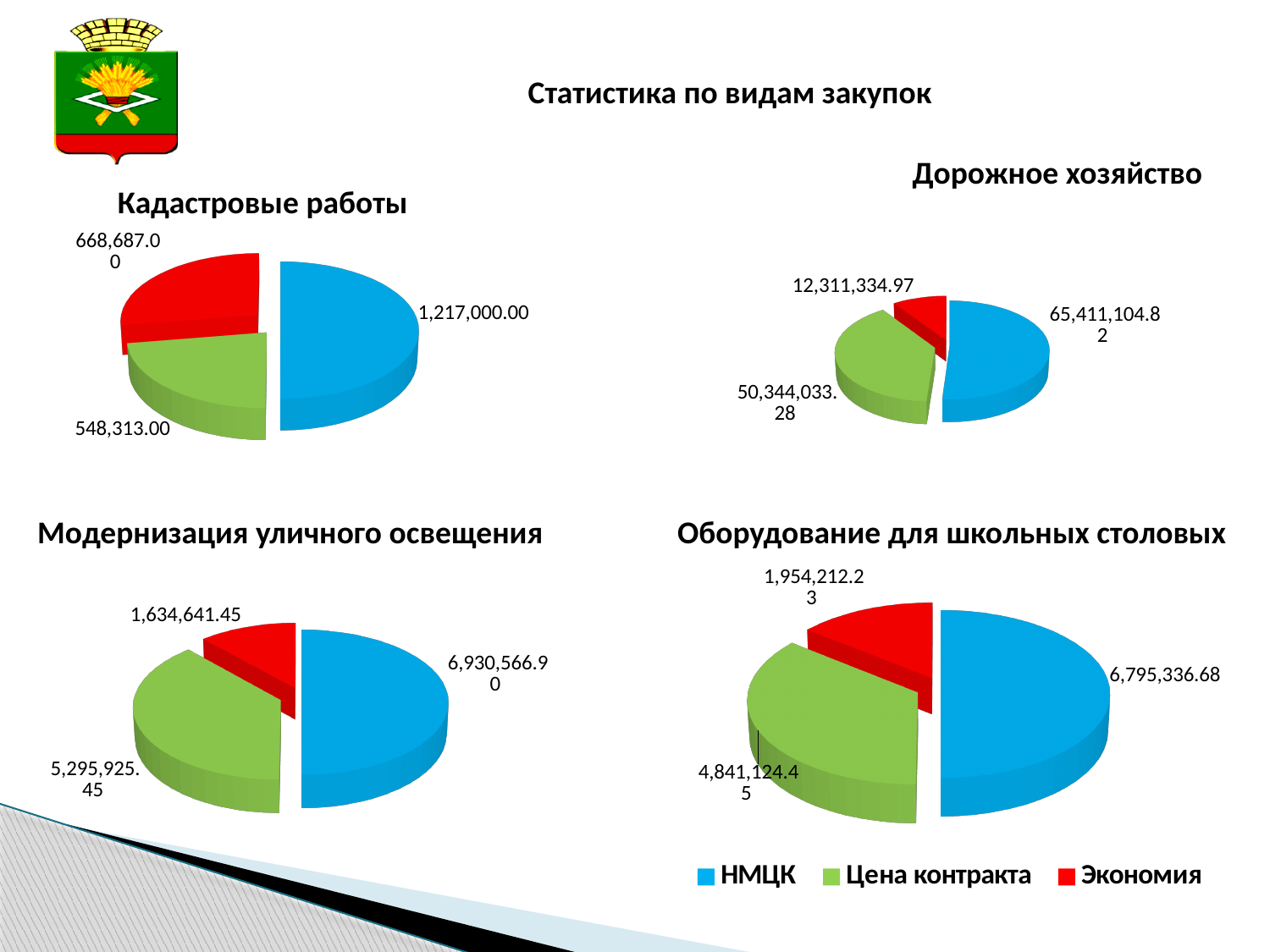
Which colour represents Цена контракта in the legend? Green How many series does the legend list? 3 What kind of charts are shown on the slide? Pie charts In the 'Кадастровые работы' chart, what is the value for Цена контракта? 548,313.00 In the 'Дорожное хозяйство' chart, which slice is the smallest? Экономия In the 'Кадастровые работы' chart, which is larger: Экономия or Цена контракта? Экономия In the 'Оборудование для школьных столовых' chart, which slice is the largest? НМЦК In the 'Дорожное хозяйство' chart, what is the value for Экономия? 12,311,334.97 In the 'Модернизация уличного освещения' chart, what is the difference between НМЦК and Цена контракта? 1,634,641.45 In the 'Оборудование для школьных столовых' chart, what is the value for Экономия? 1,954,212.23 In the 'Модернизация уличного освещения' chart, what is the value for Цена контракта? 5,295,925.45 In the 'Кадастровые работы' chart, what is the value for НМЦК? 1,217,000.00